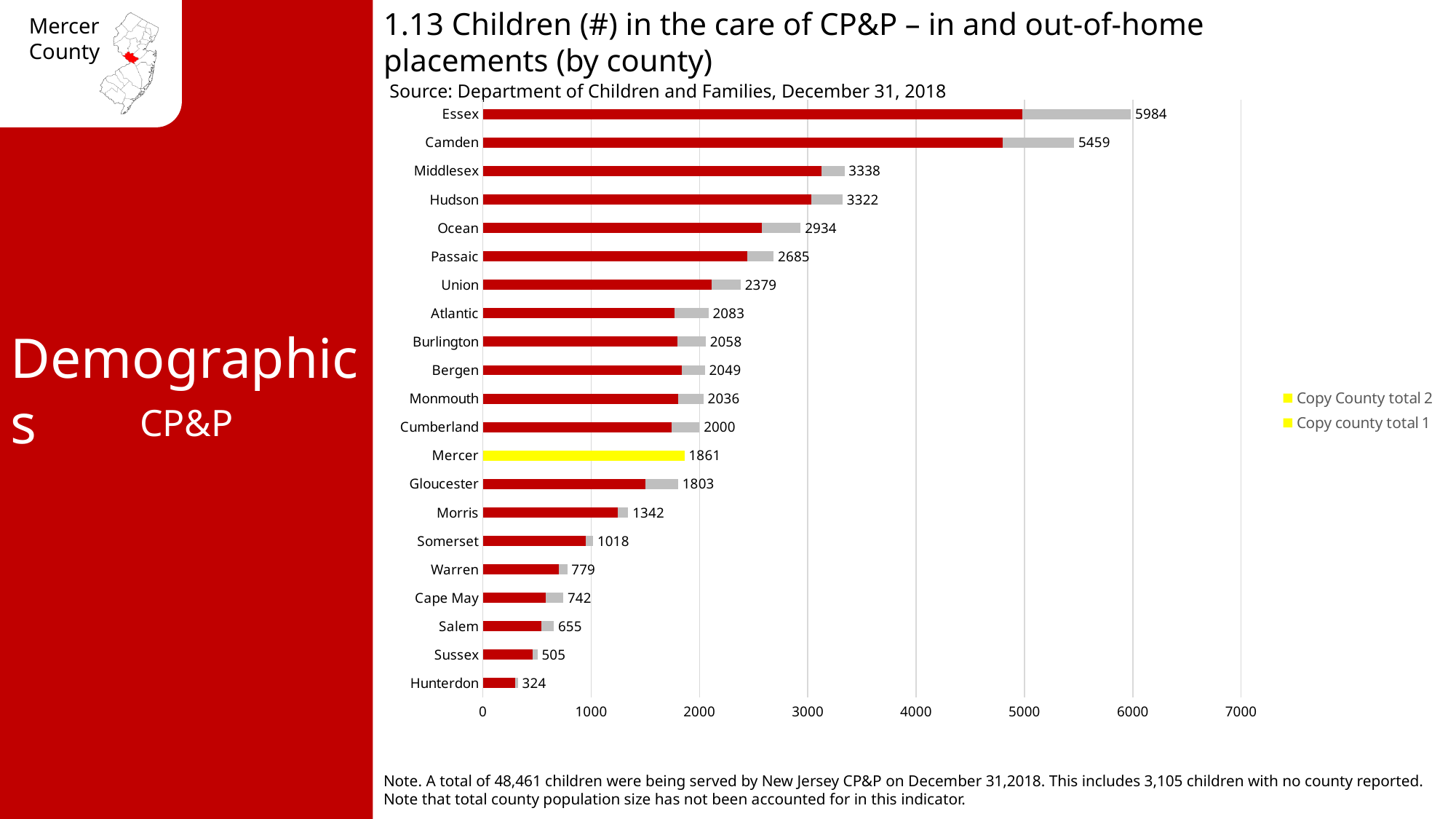
What kind of chart is shown on the slide? Stacked bar chart Is the total for Ocean greater or less than 3000? less Which county has a larger total, Middlesex or Hudson? Middlesex How many series does the legend list? 2 Which county's bar is highlighted in yellow? Mercer Which county has the lowest total number of children in the care of CP&P? Hunterdon What is the total number of children in the care of CP&P for Hunterdon? 324 What is the difference between the totals for Essex and Camden? 525 Which county has the highest total number of children in the care of CP&P? Essex What is the total number of children in the care of CP&P for Mercer? 1861 How many counties are shown in the chart? 21 What is the total number of children in the care of CP&P for Essex? 5984